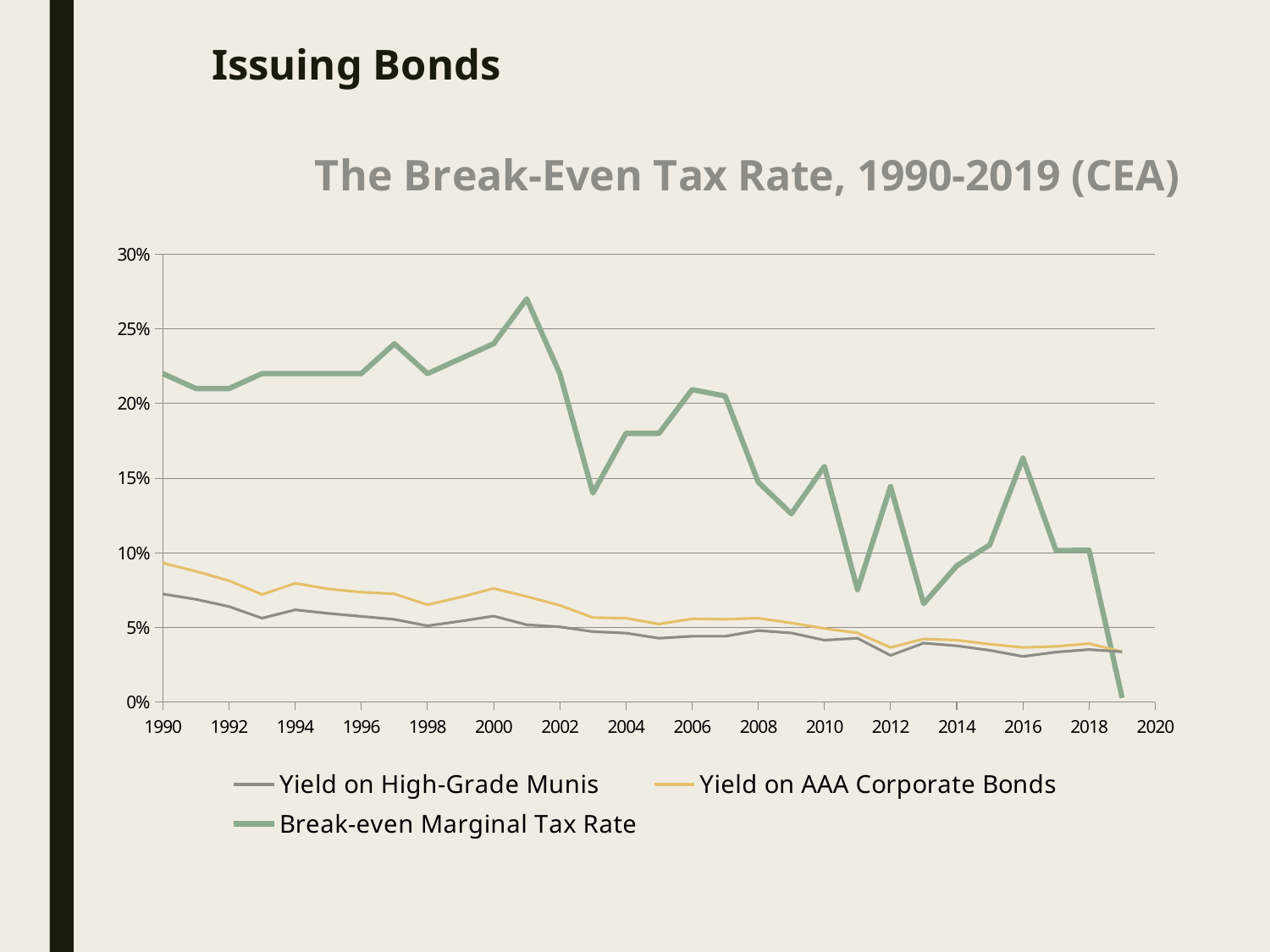
In 1990, which is higher: the Yield on AAA Corporate Bonds or the Yield on High-Grade Munis? Yield on AAA Corporate Bonds What kind of chart is shown on the slide? Line chart Is the Yield on High-Grade Munis in 1990 greater or less than 5%? greater In which year is the Break-even Marginal Tax Rate at its lowest? 2019 Which colour is used for the Break-even Marginal Tax Rate line? Green Is the Yield on AAA Corporate Bonds in 1990 greater or less than 10%? less Is the Break-even Marginal Tax Rate in 2001 greater or less than 25%? greater What is the title of the chart? The Break-Even Tax Rate, 1990-2019 (CEA) In which year does the Break-even Marginal Tax Rate reach its highest value? 2001 Does the Yield on High-Grade Munis generally rise or fall from 1990 to 2019? Fall How many series does the legend list? 3